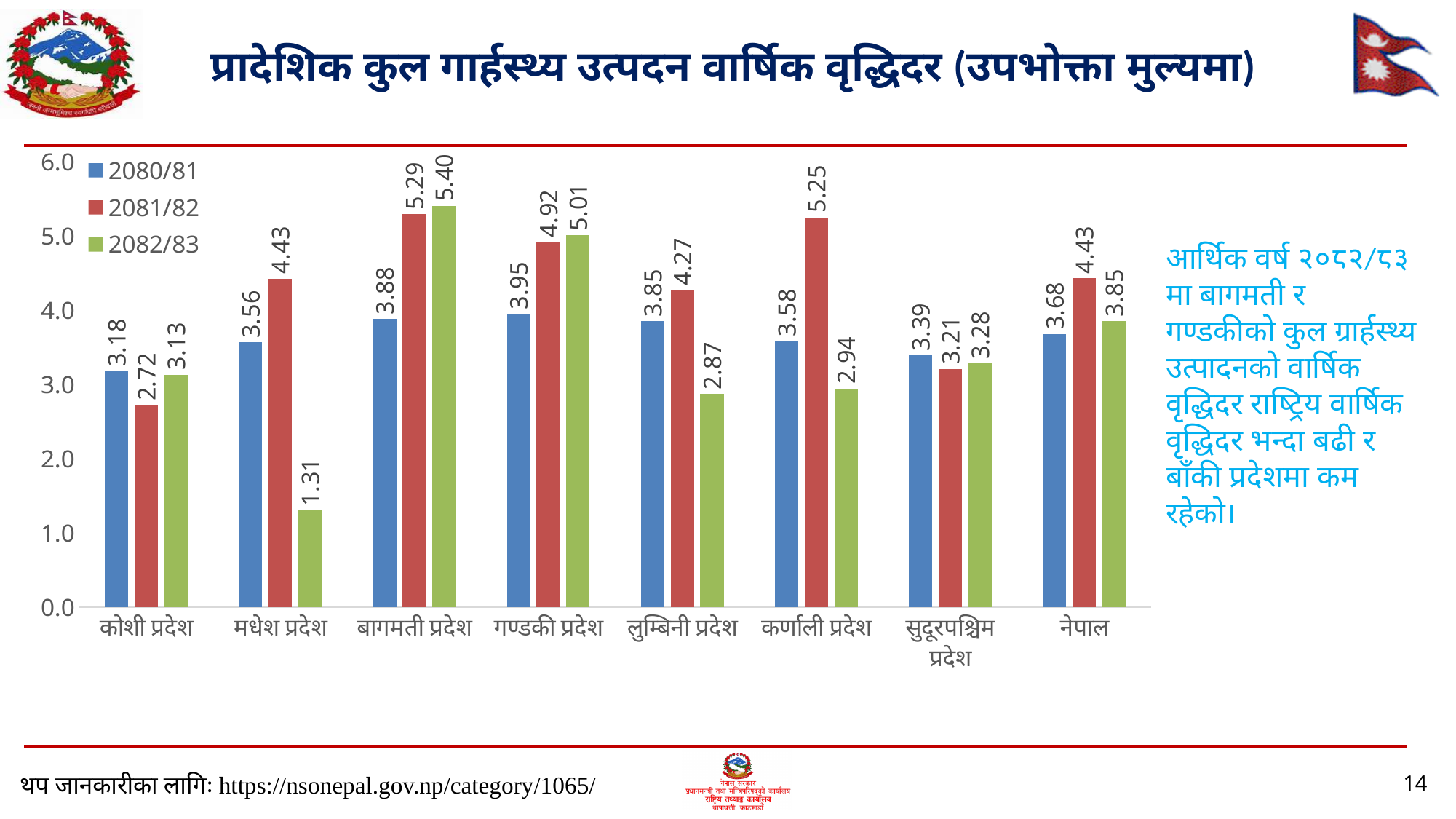
Which category has the lowest value in the 2081/82 series? कोशी प्रदेश What is the value for बागमती प्रदेश in the 2082/83 series? 5.40 Which category has the highest value in the 2082/83 series? बागमती प्रदेश What is the value for नेपाल in the 2081/82 series? 4.43 How many categories are shown on the x axis? 8 How many series does the legend list? 3 Is the 2082/83 value for गण्डकी प्रदेश greater or less than 5.0? greater Which series is shown in green in the legend? 2082/83 What is the value for मधेश प्रदेश in the 2082/83 series? 1.31 What is the difference between the 2081/82 and 2080/81 values for कर्णाली प्रदेश? 1.67 What kind of chart is shown on the slide? bar chart Which is larger for लुम्बिनी प्रदेश: the 2080/81 value or the 2082/83 value? 2080/81